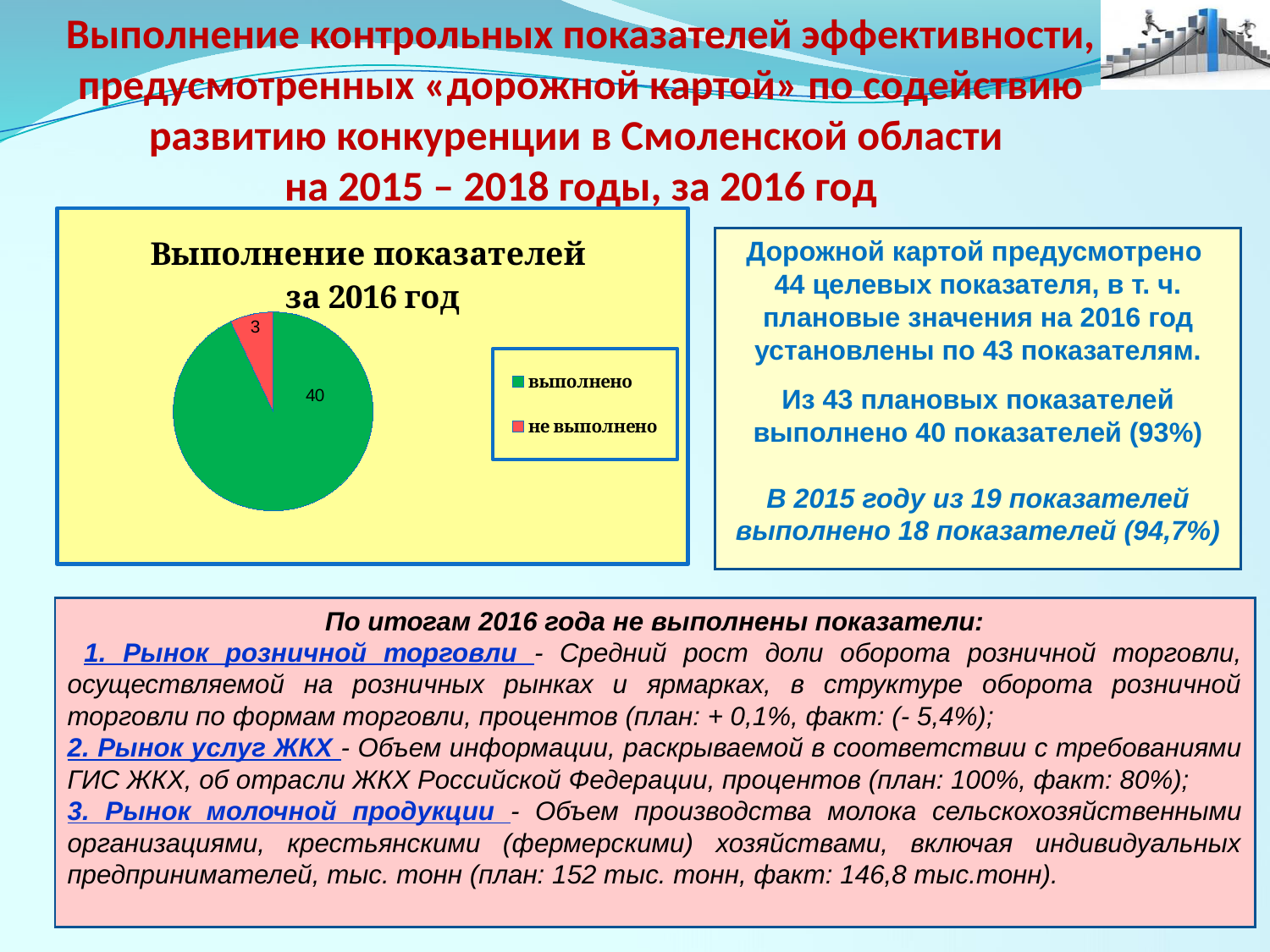
How many slices does the pie chart have? 2 What is the title of the pie chart? Выполнение показателей за 2016 год What is the value for «не выполнено» in the pie chart? 3 What is the value for «выполнено» in the pie chart? 40 What is the total of all slices in the pie chart? 43 Which slice of the pie chart is the largest? выполнено What is the difference between the «выполнено» and «не выполнено» values in the pie chart? 37 What share of the pie chart does the «выполнено» slice represent? 93% How many entries does the legend of the pie chart list? 2 Which slice of the pie chart is the smallest? не выполнено What type of chart is shown on the slide? pie chart Which is larger in the pie chart: «выполнено» or «не выполнено»? выполнено